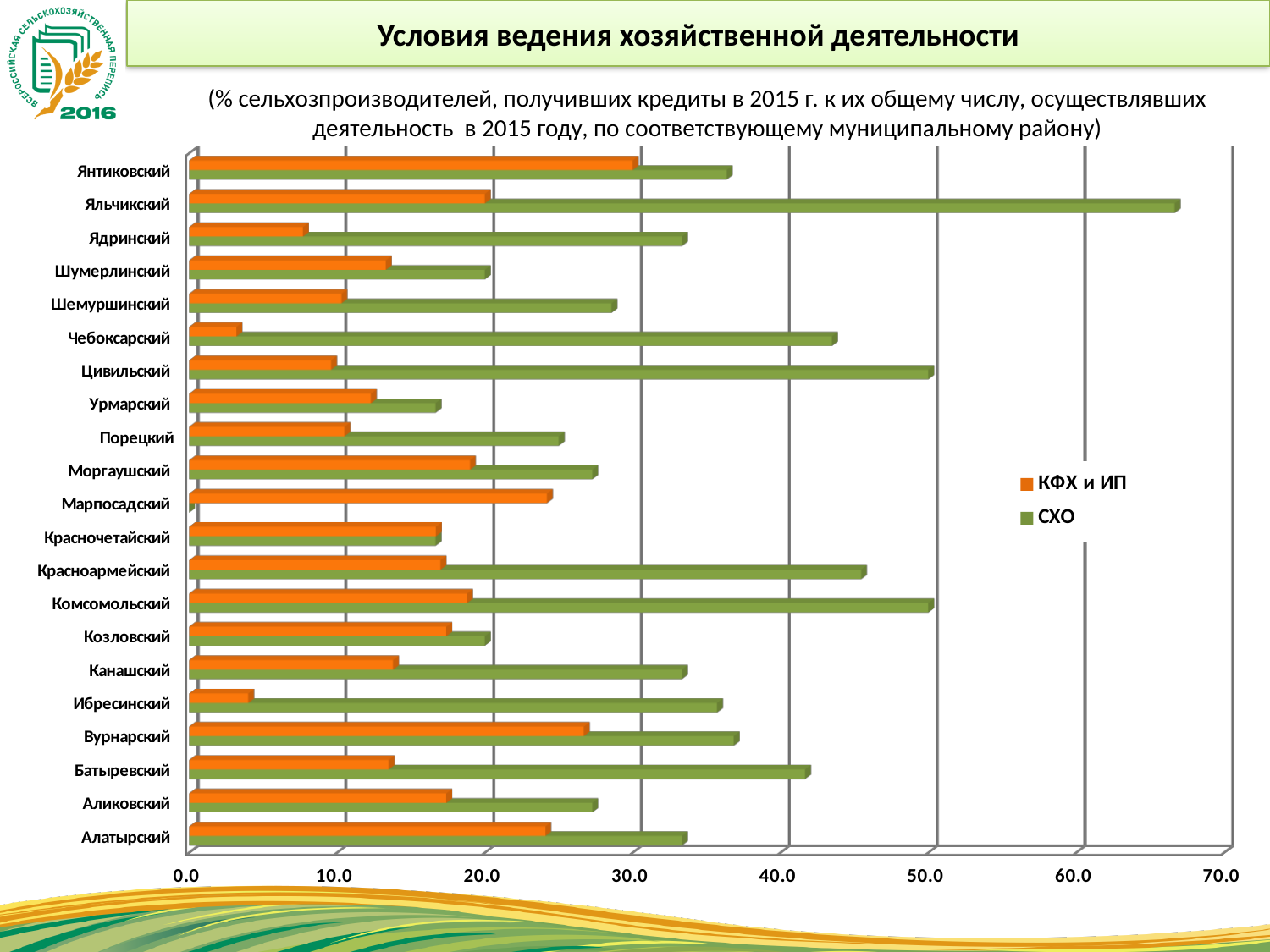
Is the СХО value for Чебоксарский greater or less than 40.0? greater Which district has the highest value for the СХО series? Яльчикский Is the КФХ и ИП value for Ядринский greater or less than 10.0? less Is the СХО value for Яльчикский greater or less than 60.0? greater How many series does the legend list? 2 What kind of chart is shown on the slide? bar chart For Яльчикский, which series has the larger value, КФХ и ИП or СХО? СХО Which district has the highest value for the КФХ и ИП series? Янтиковский For Марпосадский, which series has the larger value, КФХ и ИП or СХО? КФХ и ИП What colour are the bars for the СХО series? green How many municipal districts (categories) are plotted on the chart? 21